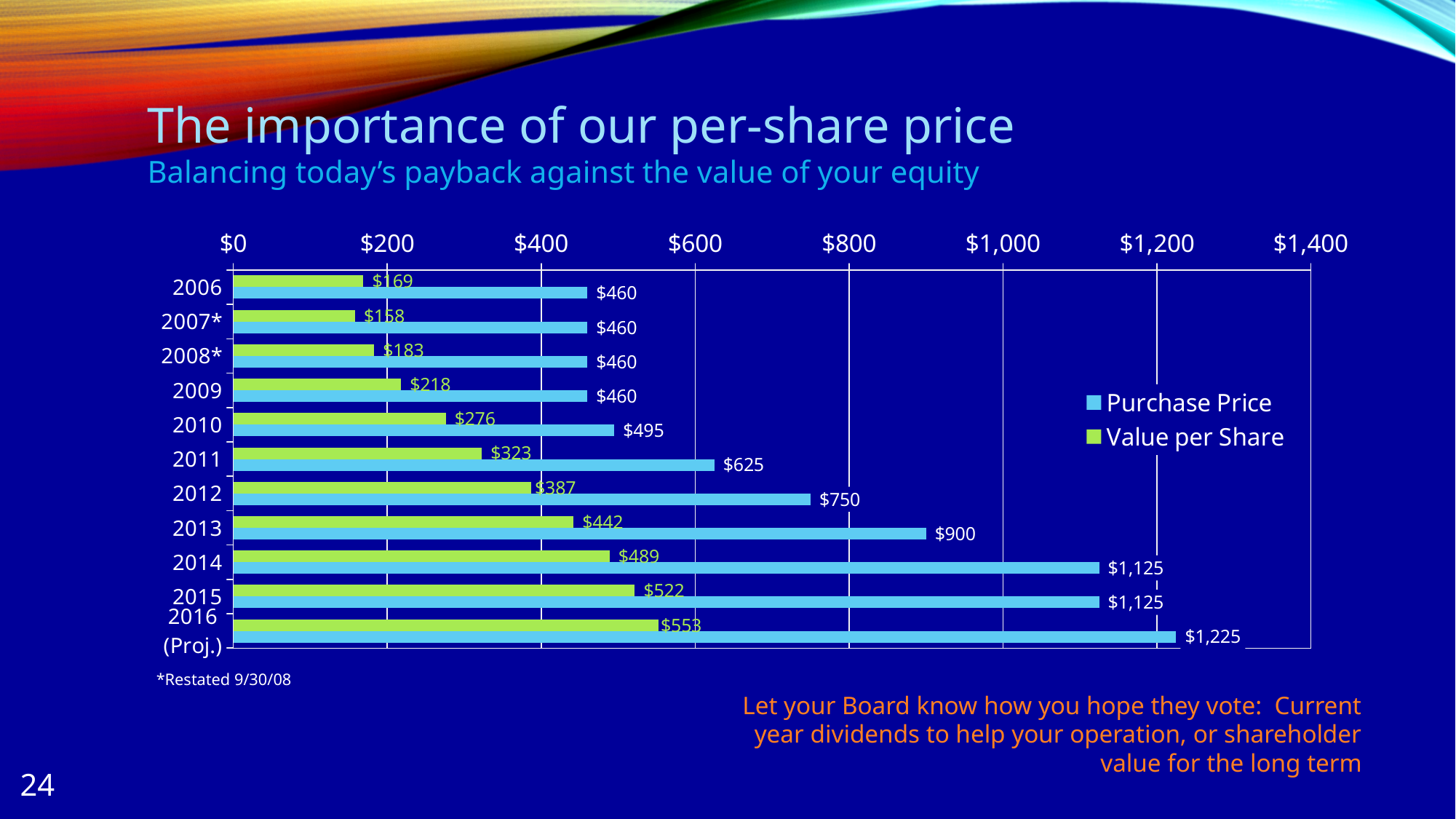
What is the Value per Share for 2016 (Proj.)? $553 What is the difference between the Purchase Price and the Value per Share in 2013? $458 Which is larger, the Purchase Price in 2011 or the Purchase Price in 2010? 2011 Which year has the lowest Value per Share? 2007* What is the Purchase Price for 2012? $750 What is the Value per Share for 2010? $276 How many years are shown on the chart? 11 How many series does the legend list? 2 Is the Purchase Price for 2014 greater or less than $1,000? greater Which series is shown in green in the legend? Value per Share Which year has the highest Purchase Price? 2016 (Proj.) What kind of chart is shown on the slide? Bar chart